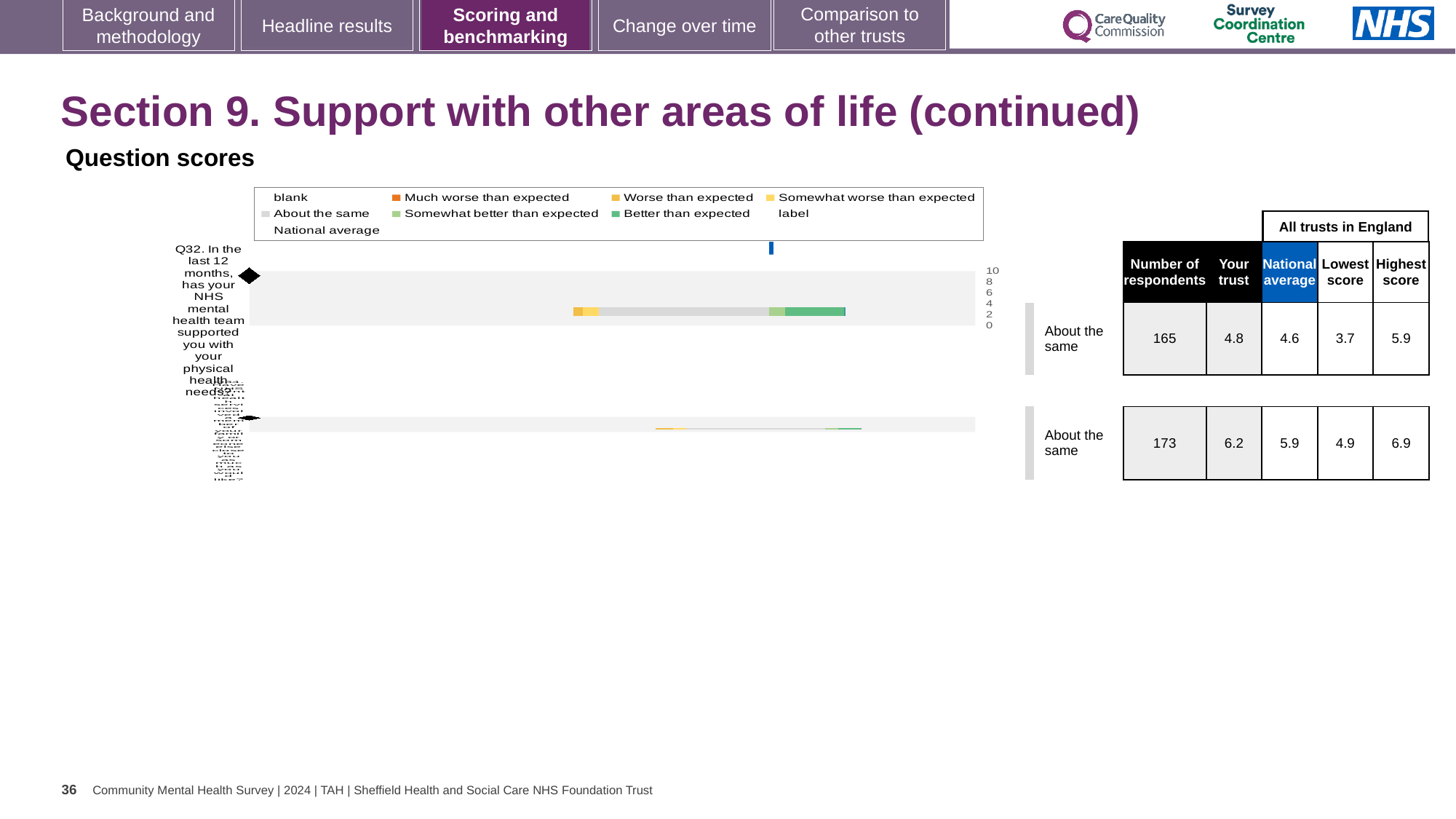
What is the 'Your trust' score for Q32 (support with physical health needs)? 4.8 How many question rows are plotted in the chart? 2 What is the highest score among all trusts in England for the second question row? 6.9 What is the lowest score among all trusts in England for Q32? 3.7 What is the 'Your trust' score for the second question row? 6.2 How many respondents answered Q32? 165 What is the difference between the highest and lowest scores for Q32? 2.2 Which legend entry is shown in orange? Much worse than expected For Q32, which is larger: the 'Your trust' score or the national average? Your trust What kind of chart is shown on the slide? bar chart What is the difference between the 'Your trust' score and the national average for the second question row? 0.3 What is the national average score for Q32? 4.6